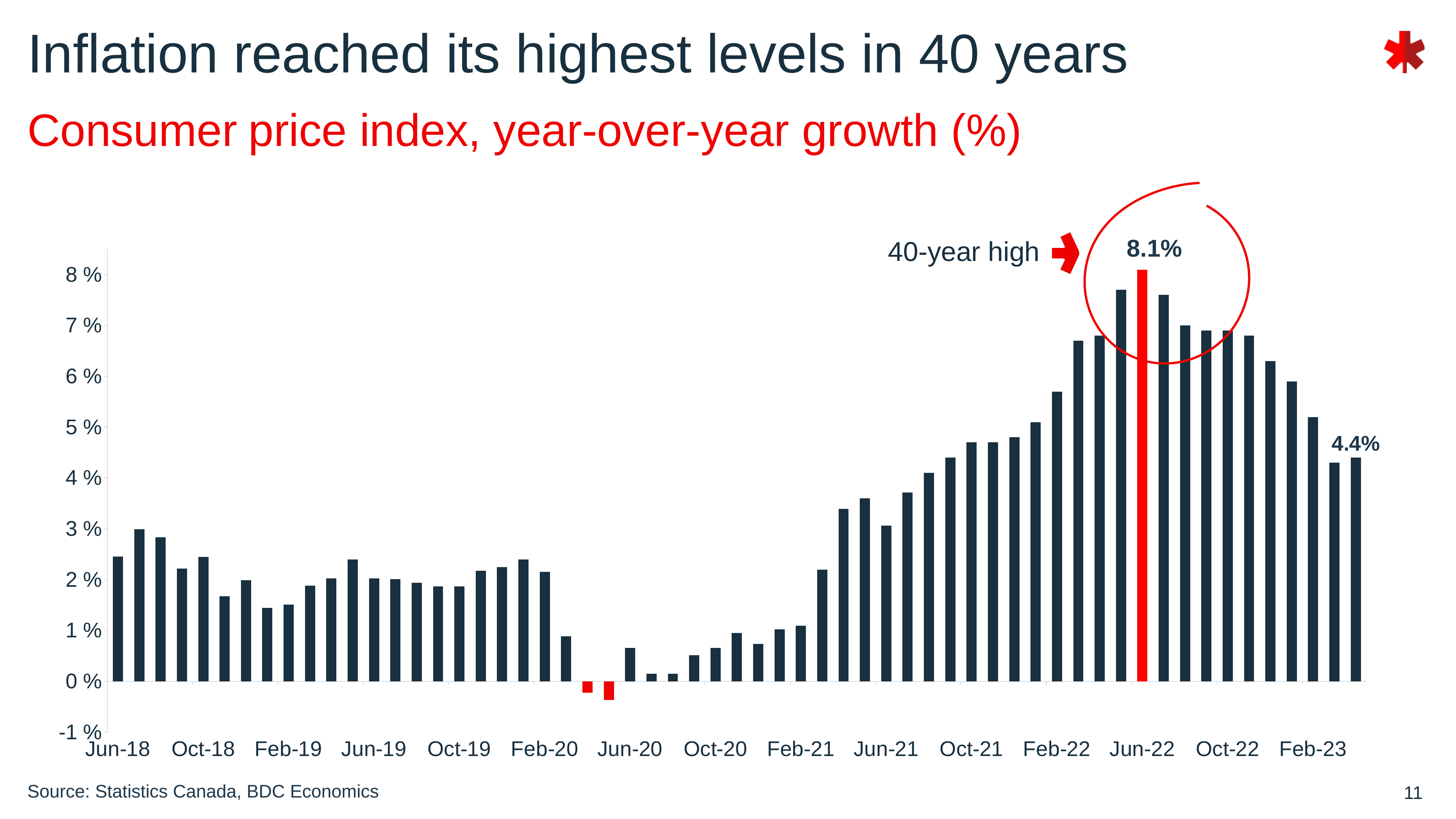
In which month does the chart reach its highest value? Jun-22 What kind of chart is shown on the slide? Bar chart What value is labeled on the red bar marked as the 40-year high? 8.1% Which is larger, the value for Oct-18 or the value for Oct-22? Oct-22 Do the values rise or fall between Jun-21 and Jun-22? Rise How many bars on the chart show a negative value? 2 What is the difference between the 40-year high value and the value labeled on the final bar? 3.7 percentage points Is the value for Feb-22 greater or less than 5%? greater Is the value for Jun-18 greater or less than 2%? greater Do the values rise or fall between Jun-22 and Feb-23? Fall What does the red annotation next to the tallest bar say? 40-year high What value is labeled on the final bar of the chart? 4.4%